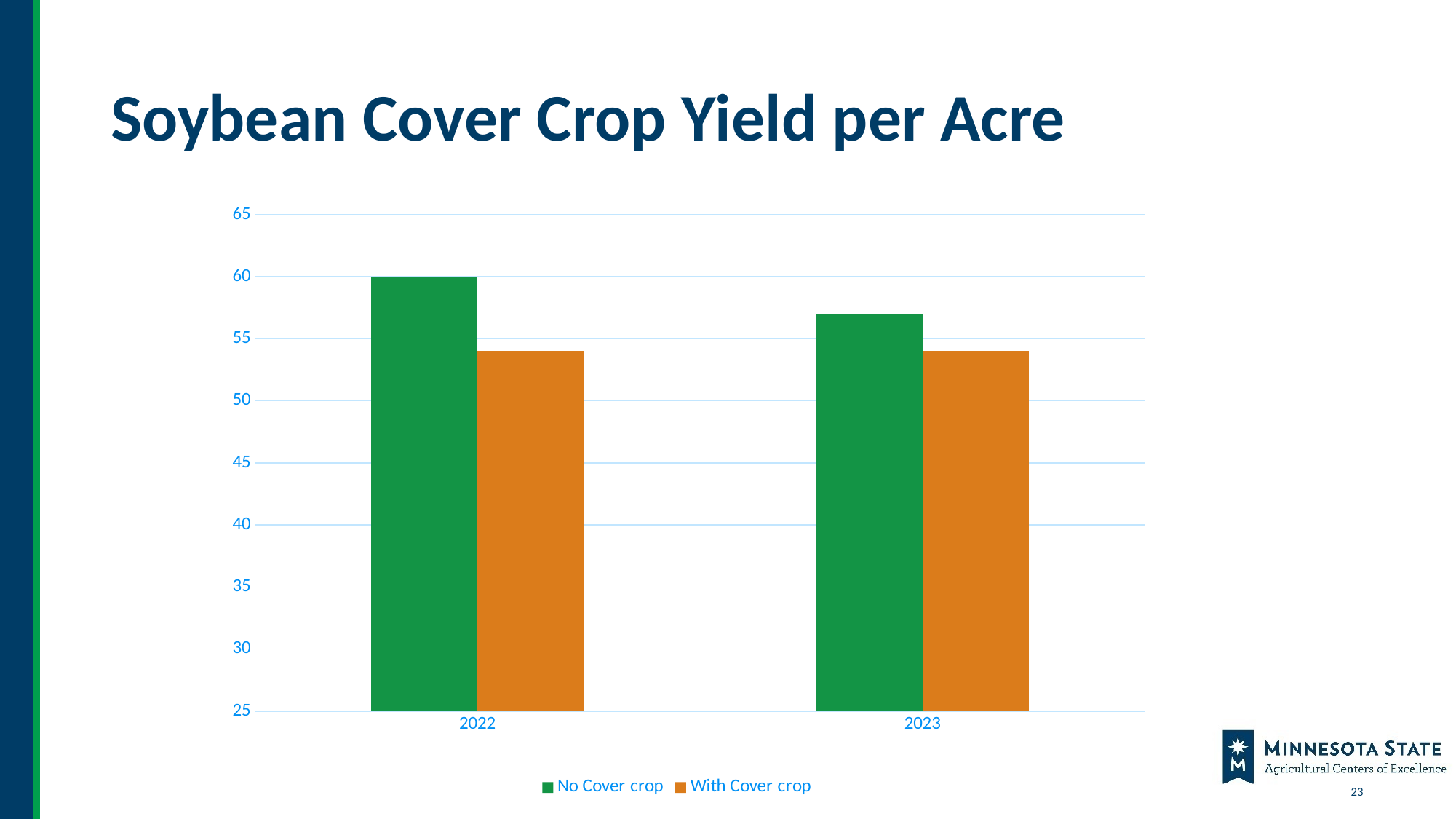
Is the value for No Cover crop in 2023 greater or less than 55? greater In 2022, which is larger: No Cover crop or With Cover crop? No Cover crop How many series does the legend list? 2 Is the value for With Cover crop in 2022 greater or less than 50? greater Which bar is the highest in the chart? No Cover crop in 2022 What is the value for No Cover crop in 2022? 60 For No Cover crop, which year has the larger value: 2022 or 2023? 2022 What type of chart is shown on the slide? Bar chart Does the No Cover crop value rise or fall from 2022 to 2023? Fall How many years are shown on the x axis? 2 What is the title of the chart? Soybean Cover Crop Yield per Acre In 2023, which is larger: No Cover crop or With Cover crop? No Cover crop